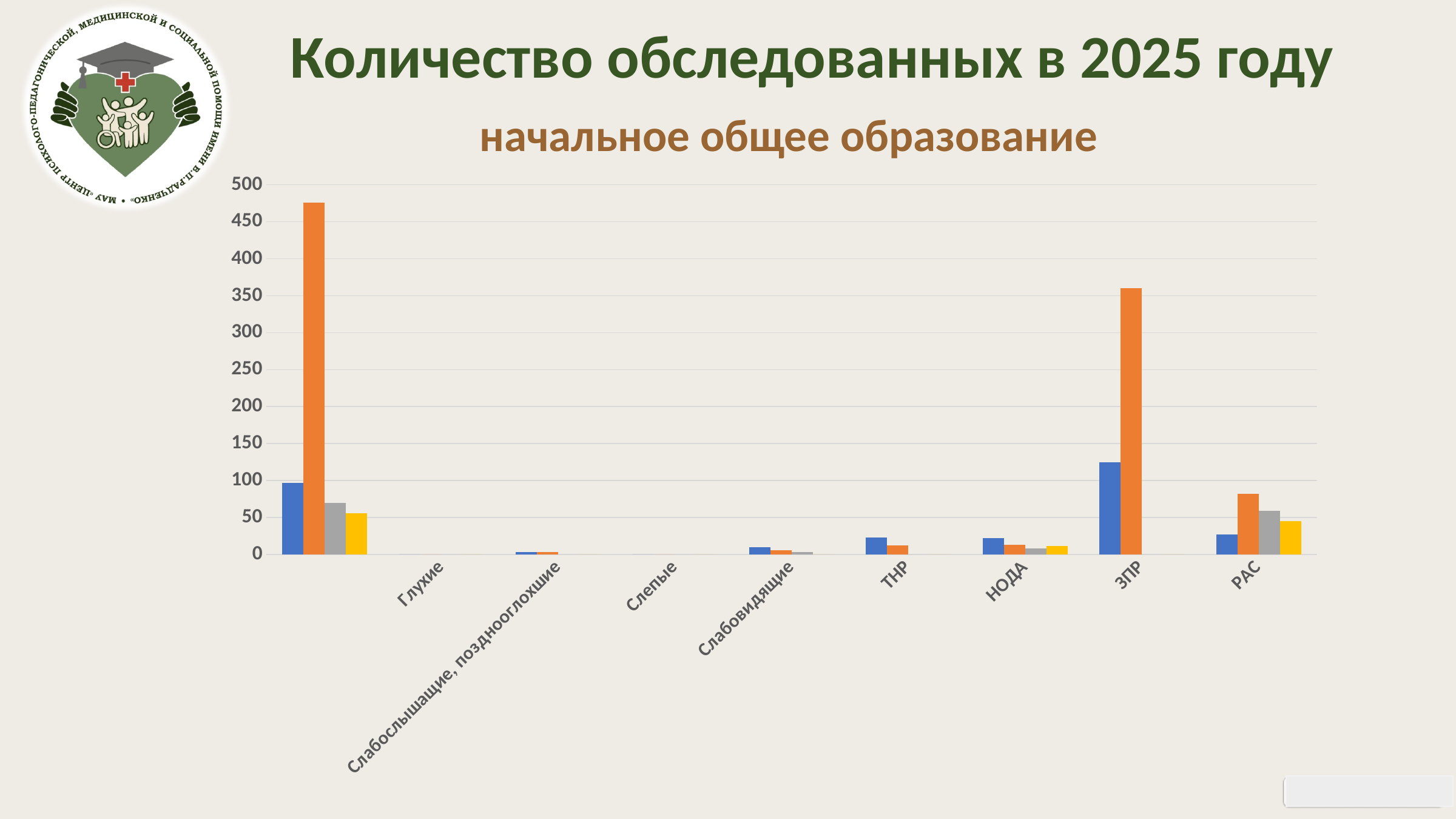
Is the value of the gray bar for РАС greater or less than 50? greater What is the title of the chart on the slide? Количество обследованных в 2025 году Is the value of the orange bar for РАС greater or less than 100? less Is the value of the blue bar for ЗПР greater or less than 100? greater Which has the larger blue bar, ЗПР or ТНР? ЗПР Which has the larger orange bar, ЗПР or РАС? ЗПР Among the labelled categories, which has the tallest orange bar? ЗПР What kind of chart is shown on the slide? bar chart What subtitle appears below the chart title? начальное общее образование